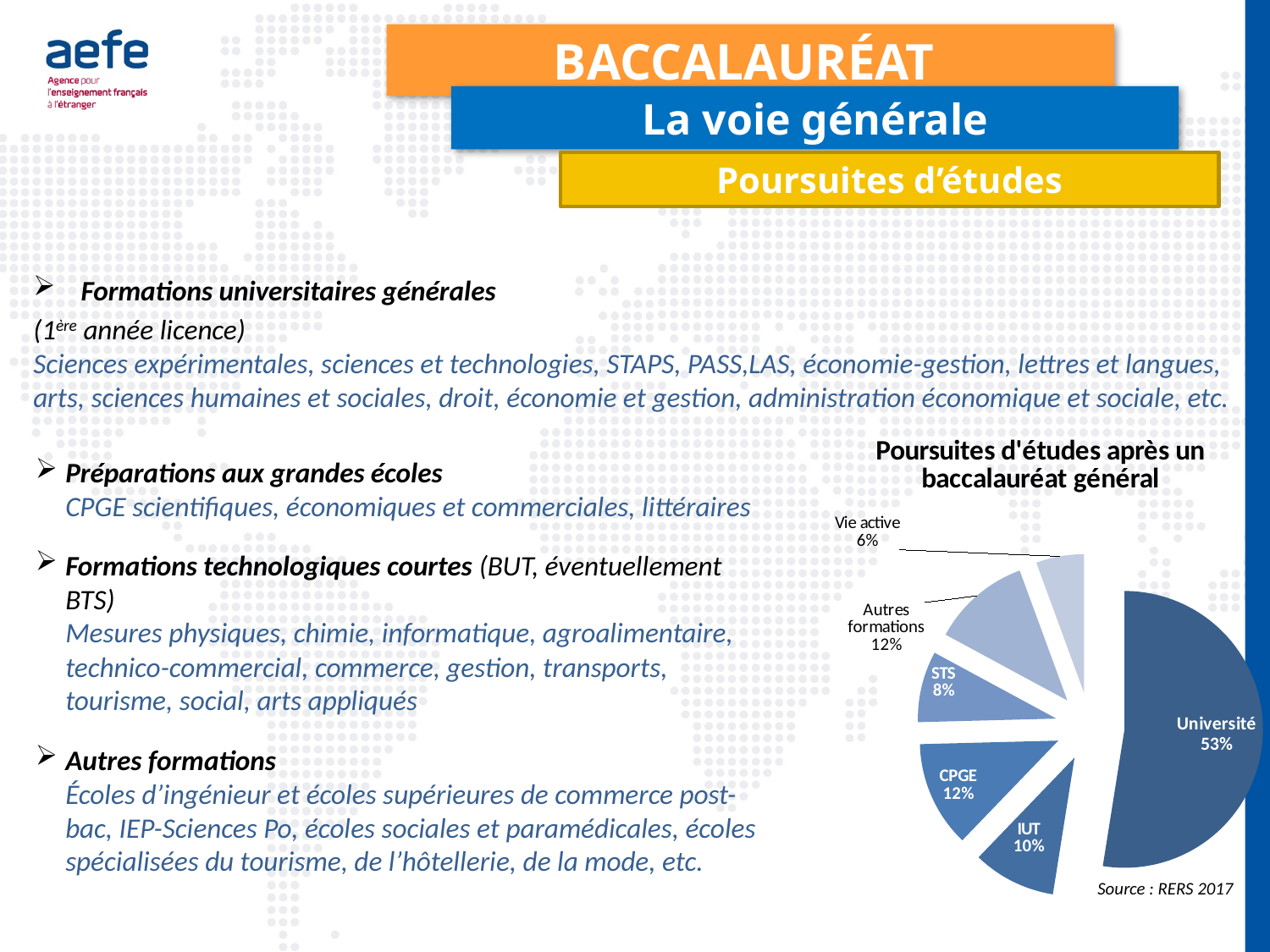
Which is larger, the share for IUT or the share for STS? IUT What source is cited below the chart? RERS 2017 What is the difference between the Université share and the CPGE share? 41% Which category has the smallest slice of the pie? Vie active What is the value shown for STS? 8% Which category has the largest slice of the pie? Université What is the value shown for IUT? 10% How many slices does the pie chart have? 6 What share of the pie does Université represent? 53% What kind of chart is shown on the slide? Pie chart What is the title of the chart? Poursuites d'études après un baccalauréat général What is the value shown for Vie active? 6%